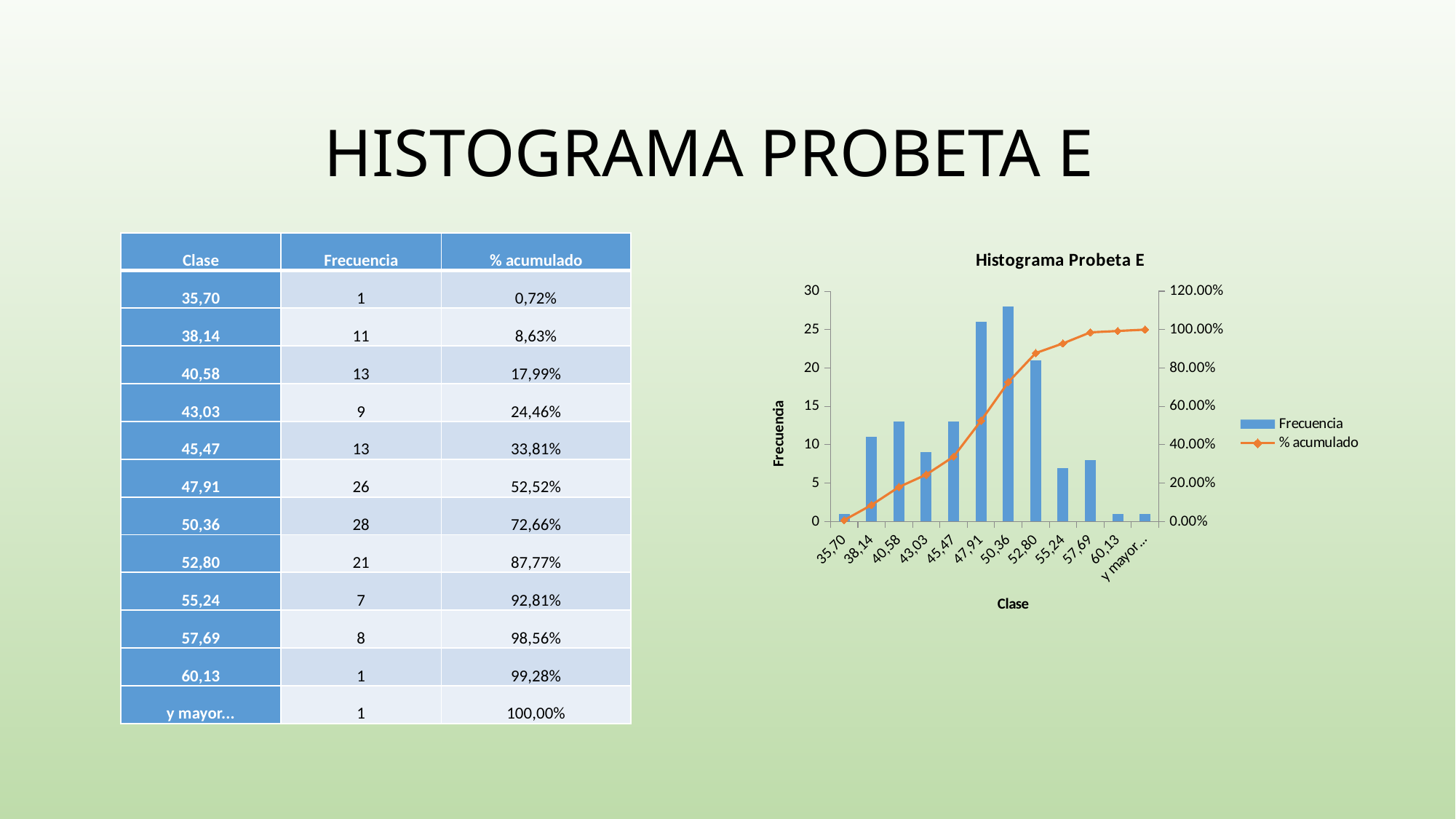
What is the title of the chart? Histograma Probeta E Is the Frecuencia bar for class 47,91 greater or less than 20? greater Does the % acumulado line rise or fall along the x axis? Rises What is the difference in Frecuencia between class 50,36 and class 52,80? 7 What is the Frecuencia for class 50,36? 28 Which has a larger Frecuencia, class 38,14 or class 55,24? 38,14 Which class has the highest Frecuencia bar? 50,36 How many classes (categories) are plotted on the x axis of the chart? 12 What type of chart is shown on the slide? Combined bar and line chart How many series does the chart legend list? 2 What is the Frecuencia for class 47,91? 26 What is the % acumulado for class 52,80? 87,77%